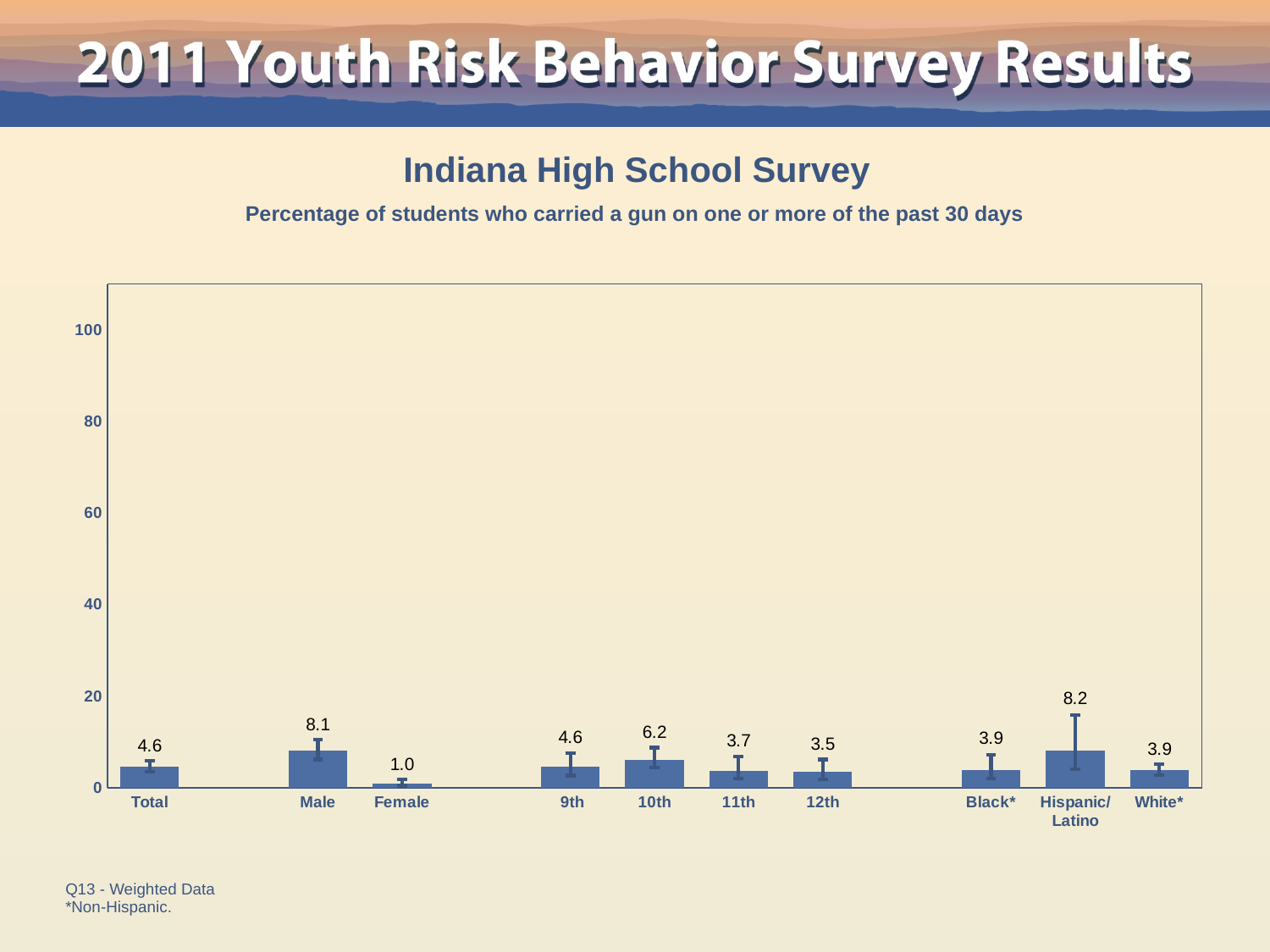
Do the values fall from 10th grade to 12th grade? yes What kind of chart is this? bar chart What is the value for Male? 8.1 What is the value for 10th grade? 6.2 What is the difference between the Male and Female values? 7.1 What is the value for Female? 1.0 Is the value for Male greater or less than 20? less How many categories are shown on the x axis? 10 Which is larger, the value for 9th grade or the value for 12th grade? 9th What is the value for Hispanic/Latino? 8.2 Which category has the highest value? Hispanic/Latino Which category has the lowest value? Female